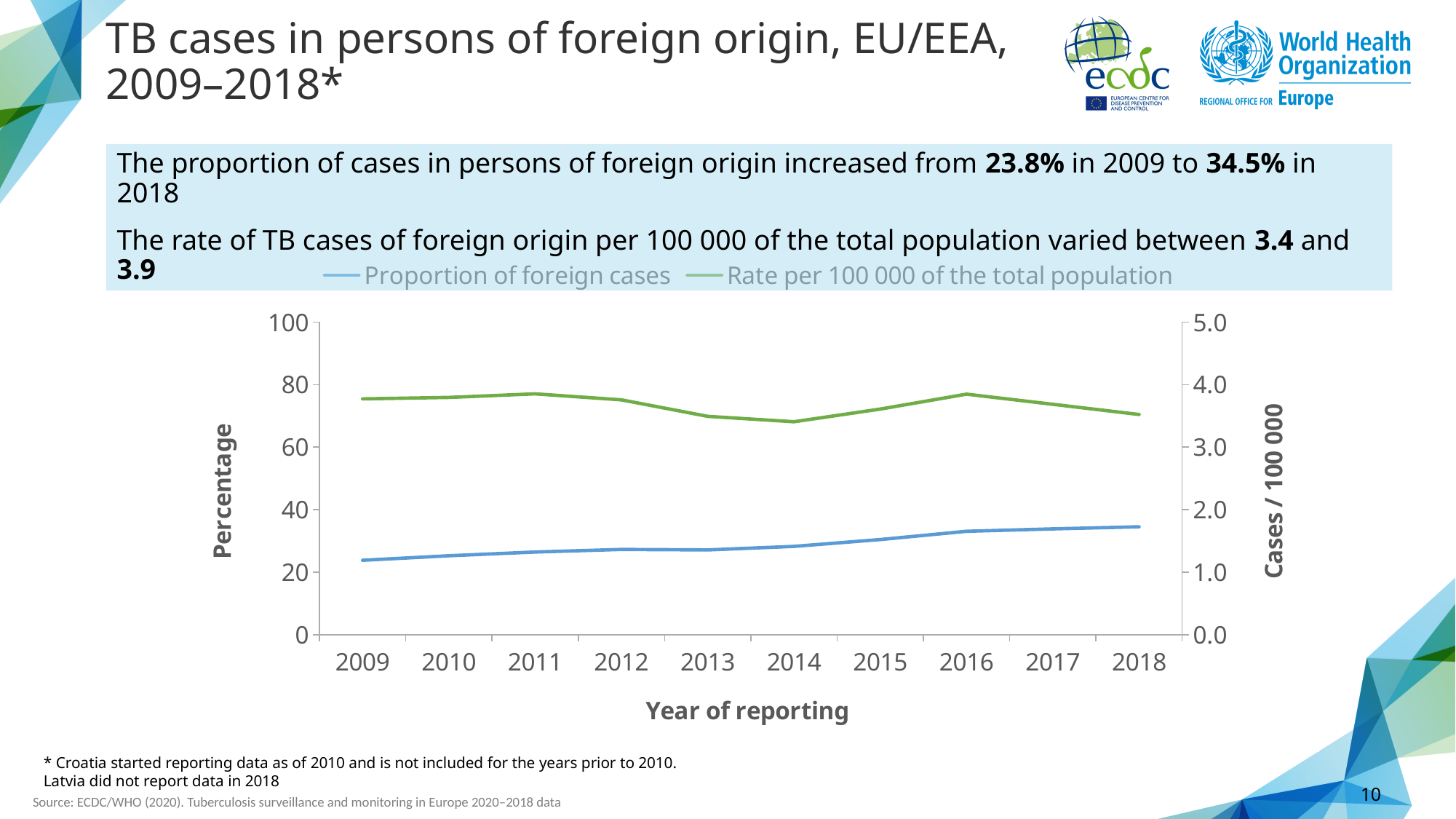
Is the proportion of foreign cases in 2009 greater or less than 40? less What was the proportion of cases in persons of foreign origin in 2018? 34.5% Is the rate per 100 000 of the total population in 2011 greater or less than 3.0? greater How many series does the chart legend list? 2 In which year is the proportion of foreign cases lowest? 2009 Is the rate per 100 000 of the total population in 2014 greater or less than 4.0? less What is the title of the x axis of the chart? Year of reporting What was the proportion of cases in persons of foreign origin in 2009? 23.8% In which year is the proportion of foreign cases highest? 2018 Does the proportion of foreign cases rise or fall from 2009 to 2018? rise How many years are plotted along the x axis of the chart? 10 What kind of chart is shown on the slide? line chart